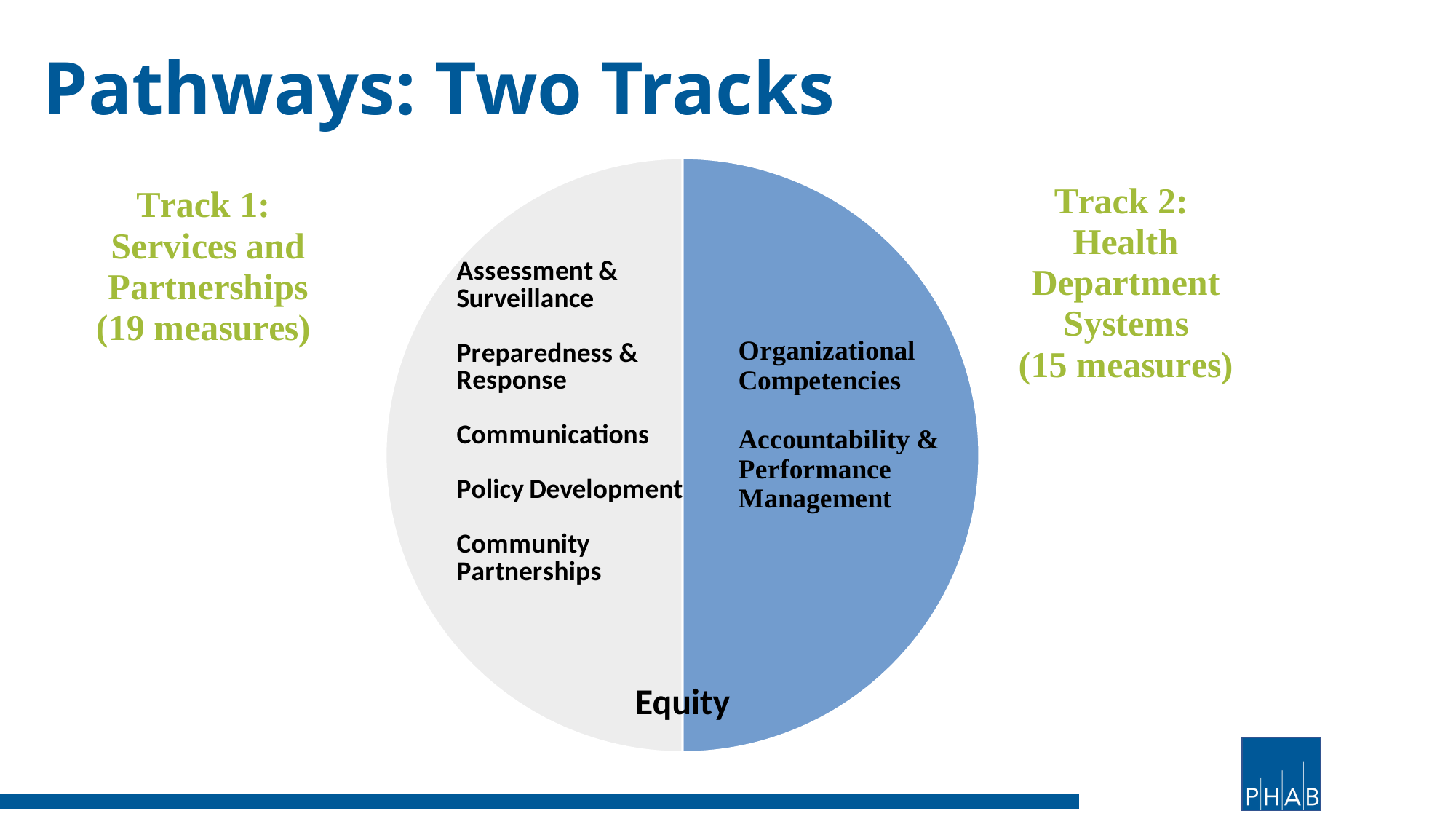
Which track has more measures, Track 1 or Track 2? Track 1 What kind of chart is shown on the slide? pie chart What is the total number of measures across both tracks? 34 How many domains are listed in the grey (Track 1) half of the circle? 5 How many measures does Track 2: Health Department Systems have? 15 measures What word appears at the bottom of the circle, spanning both halves? Equity What is the difference in the number of measures between Track 1 and Track 2? 4 How many measures does Track 1: Services and Partnerships have? 19 measures Which track has the fewest measures? Track 2: Health Department Systems How many domains are listed in the blue (Track 2) half of the circle? 2 How many slices does the circle on the slide have? 2 What colour is the half of the circle containing Organizational Competencies? blue